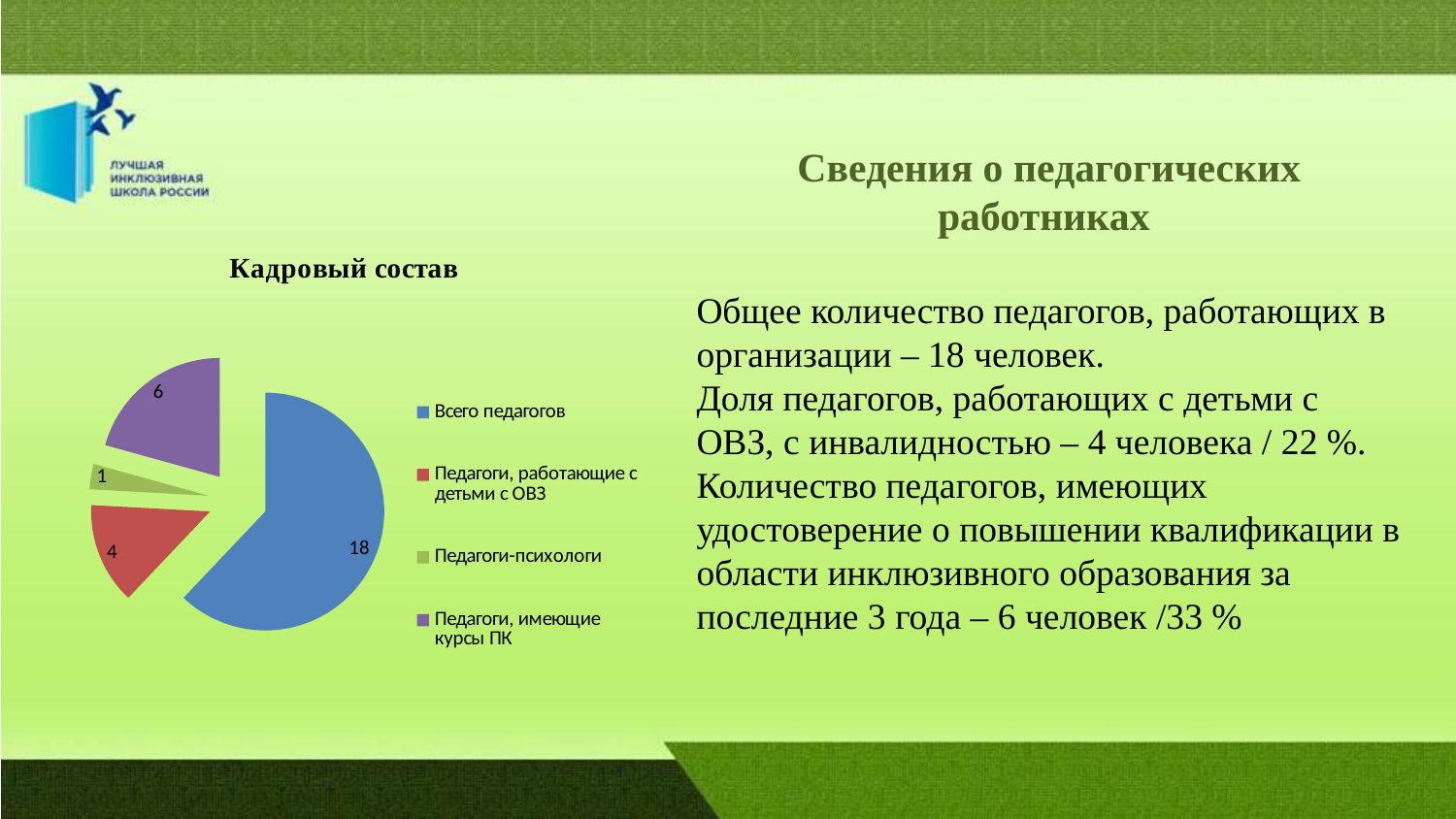
What is the title of the chart? Кадровый состав Which category has the smallest slice in the pie chart? Педагоги-психологи What is the value for "Всего педагогов" in the pie chart? 18 What is the difference between the values for "Всего педагогов" and "Педагоги, имеющие курсы ПК"? 12 What is the value for "Педагоги-психологи" in the pie chart? 1 What is the value for "Педагоги, работающие с детьми с ОВЗ" in the pie chart? 4 What type of chart is shown on the slide? pie chart What is the value for "Педагоги, имеющие курсы ПК" in the pie chart? 6 How many slices does the pie chart have? 4 Which category has the largest slice in the pie chart? Всего педагогов What colour is the slice for "Всего педагогов"? blue Which is larger: "Педагоги, имеющие курсы ПК" or "Педагоги, работающие с детьми с ОВЗ"? Педагоги, имеющие курсы ПК